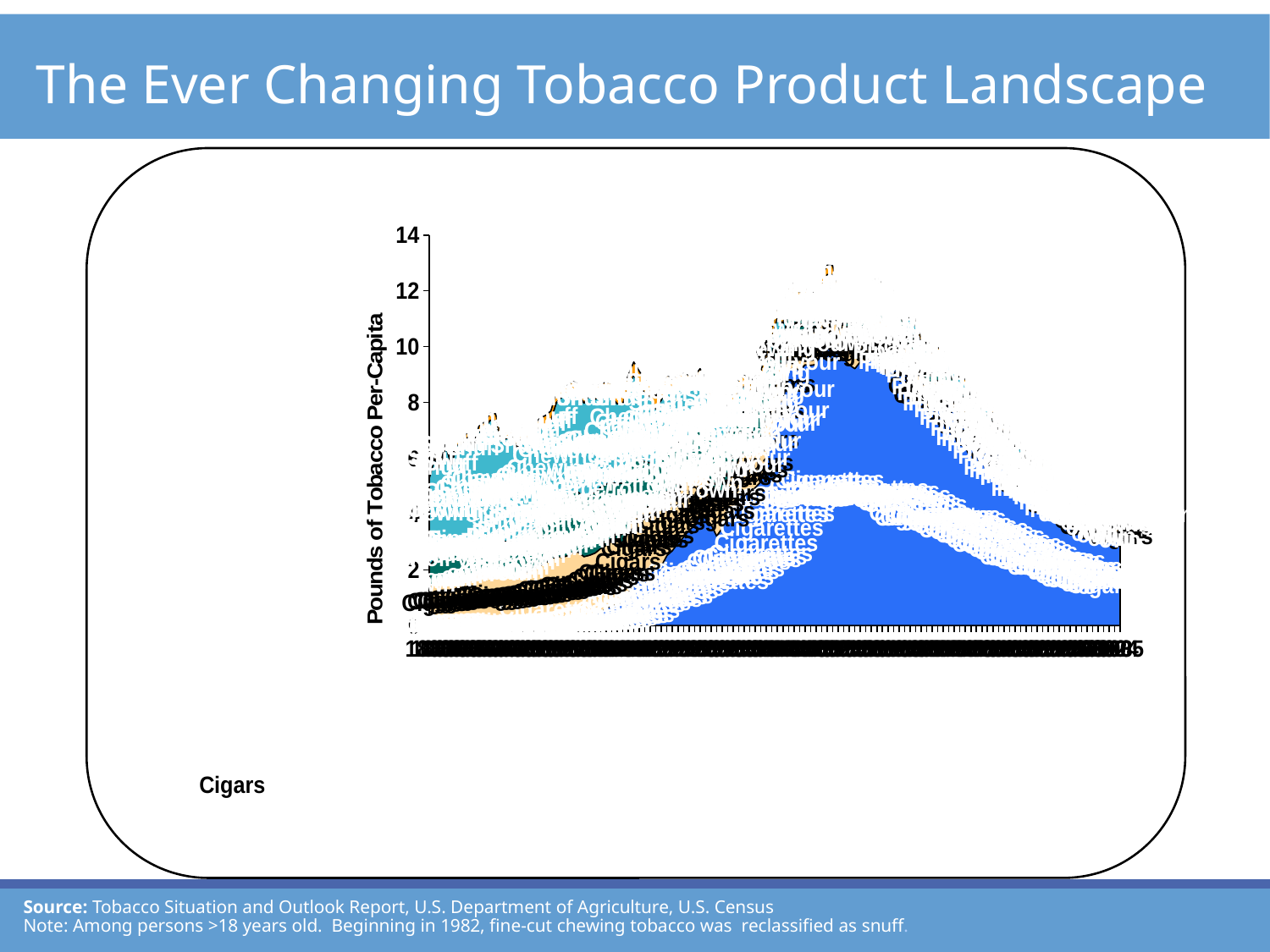
What is the label on the vertical axis of the chart? Pounds of Tobacco Per-Capita What is the highest value shown on the vertical axis of the chart? 14 Is the peak of the total stacked area in the chart greater or less than 10 pounds per capita? greater What kind of chart is shown on the slide? area chart